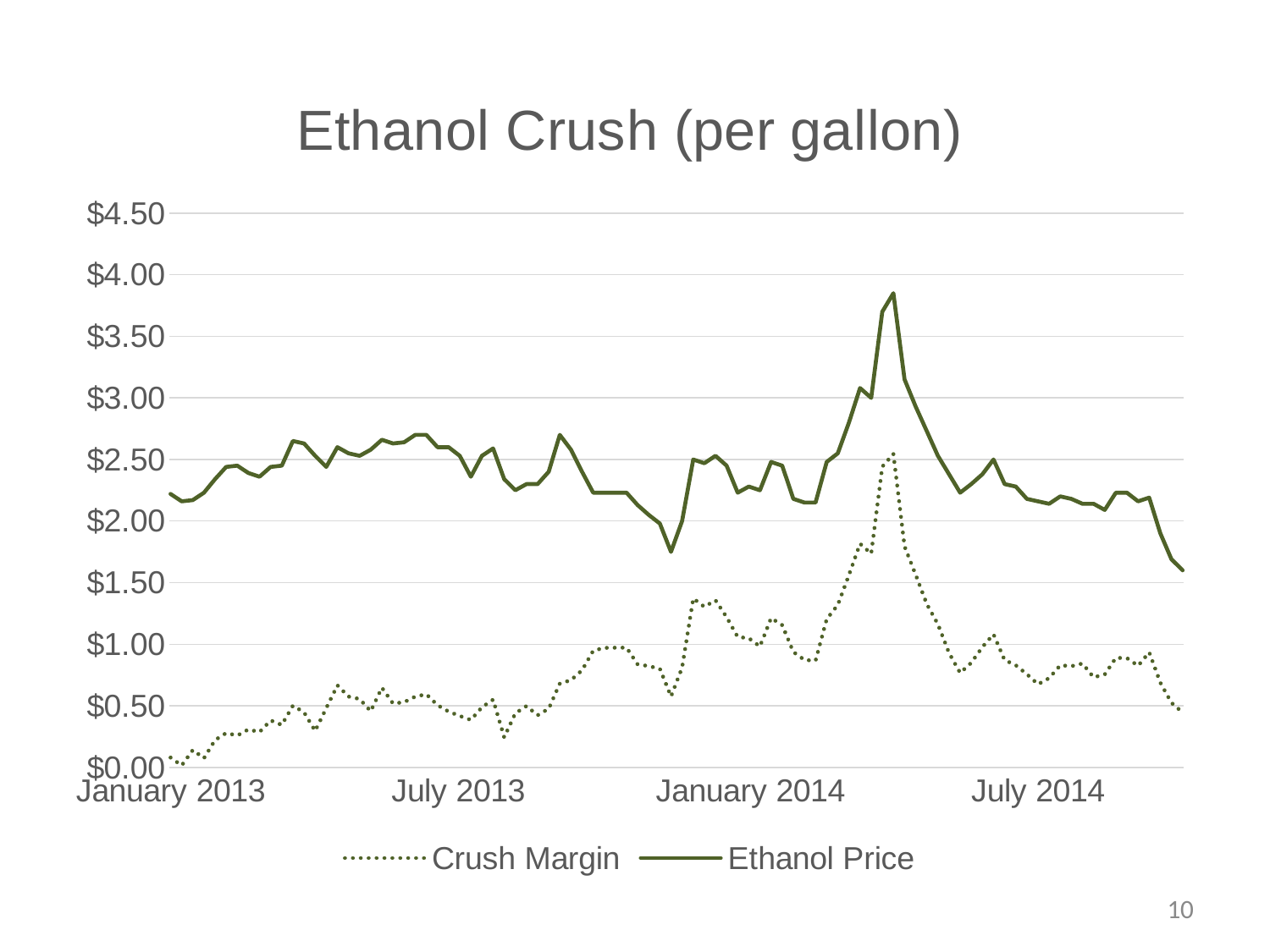
What is the title of the chart? Ethanol Crush (per gallon) How many date labels are shown on the x axis? 4 How many series does the legend list? 2 Does the Ethanol Price line rise or fall between July 2014 and the end of the chart? fall Is the highest value reached by the Crush Margin line greater or less than $2.00? greater What kind of chart is shown on the slide? line chart Is the Ethanol Price at the last point on the chart greater or less than $2.00? less Which series is drawn with a dotted line? Crush Margin Which series has the higher value at January 2013, Crush Margin or Ethanol Price? Ethanol Price Is the highest value reached by the Ethanol Price line greater or less than $3.50? greater